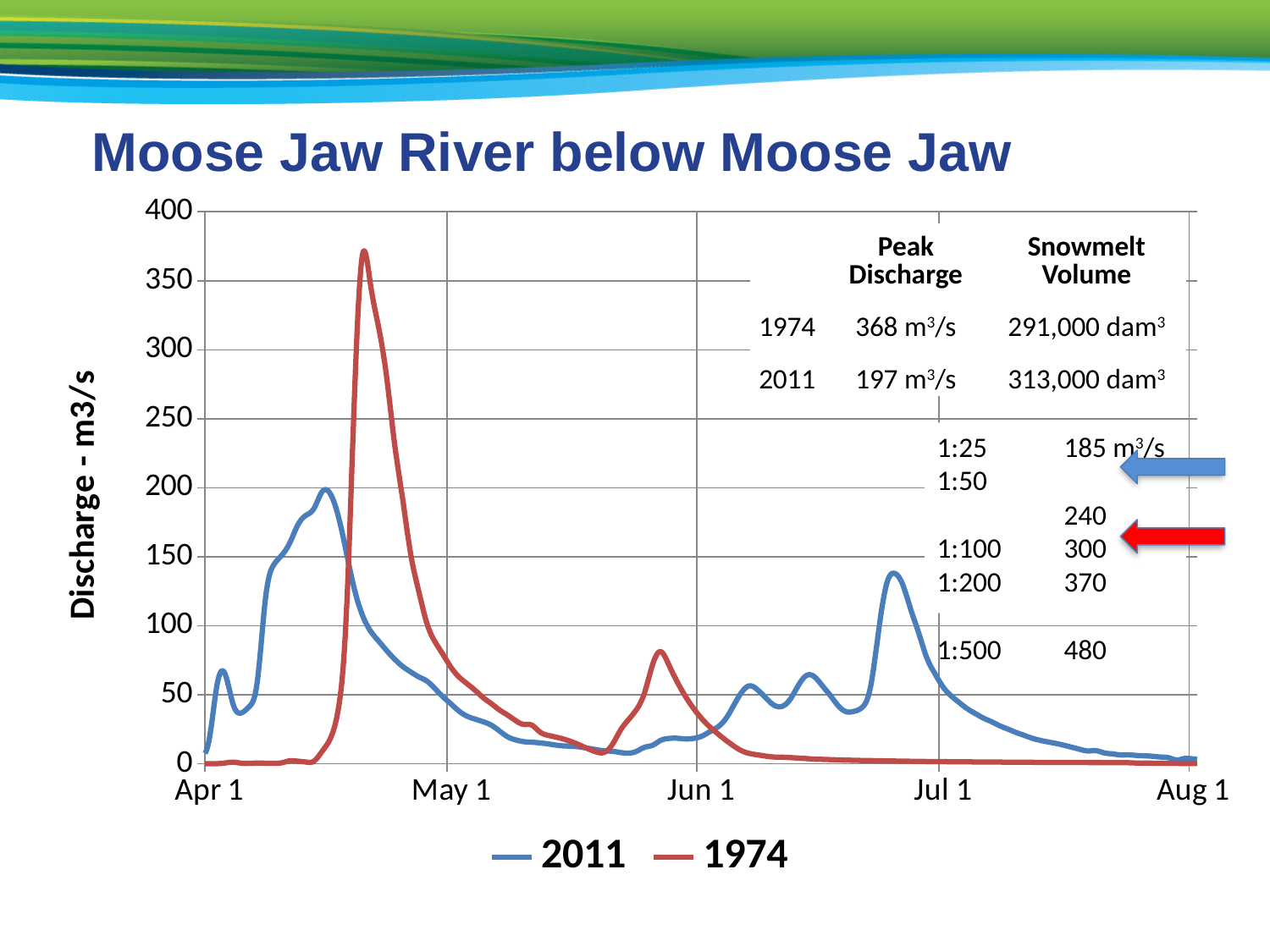
According to the table on the chart, what was the peak discharge in 1974? 368 m³/s Which year had the higher peak discharge, 1974 or 2011? 1974 What is the label on the vertical axis? Discharge - m3/s What are the two series named in the legend? 2011 and 1974 How many series does the legend list? 2 Is the peak of the 1974 line greater or less than 350 on the discharge axis? greater According to the table on the chart, what was the peak discharge in 2011? 197 m³/s What kind of chart is shown on the slide? line chart What snowmelt volume is listed for 2011? 313,000 dam³ Do the discharge values for both series rise or fall between Jul 1 and Aug 1? fall What is the difference between the 2011 and 1974 snowmelt volumes listed in the table? 22,000 dam³ What is the difference between the 1974 and 2011 peak discharges shown in the table? 171 m³/s